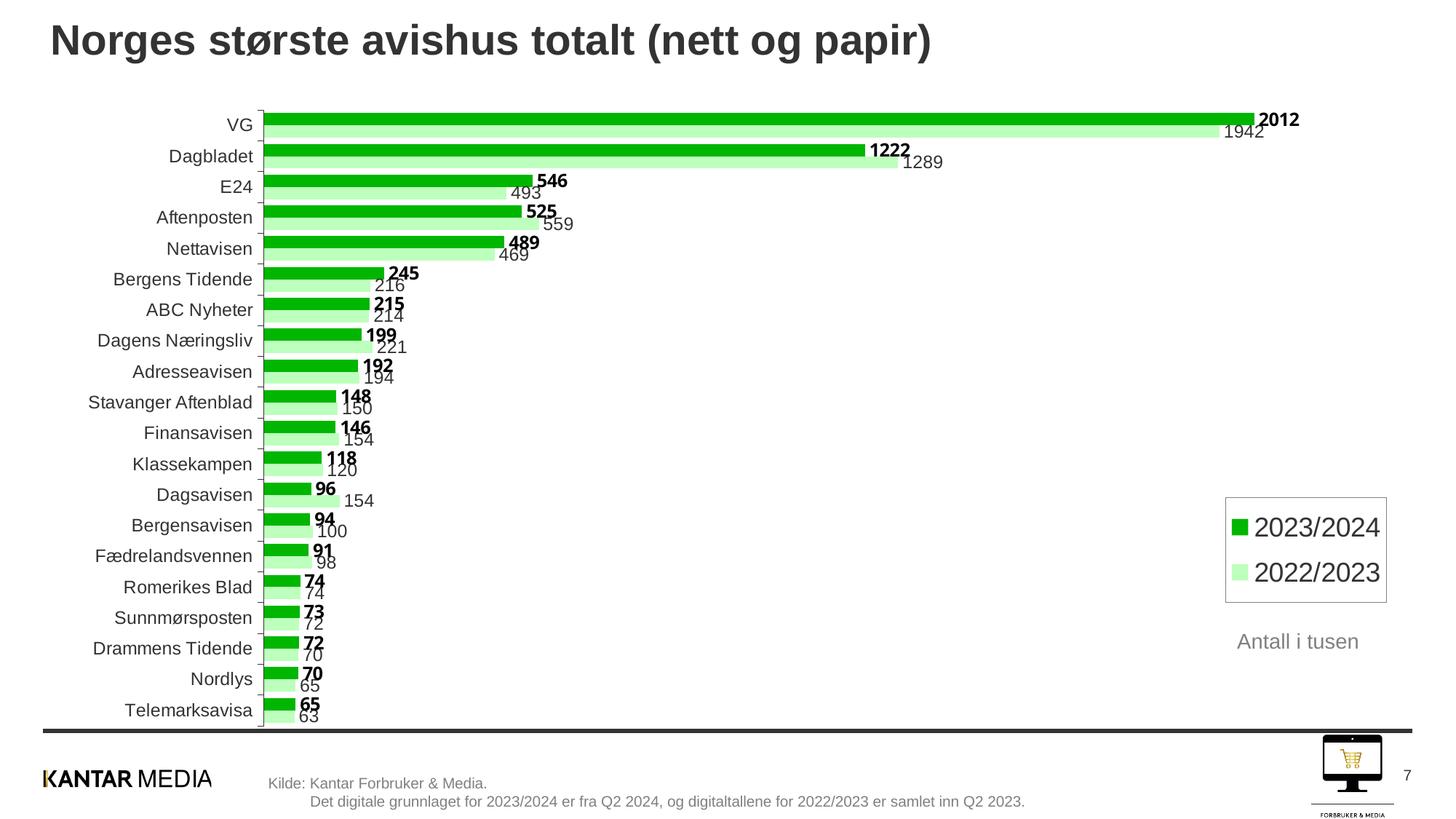
Which is larger for Aftenposten: the 2023/2024 value or the 2022/2023 value? 2022/2023 Which newspaper has the highest 2023/2024 value? VG What is the 2023/2024 value for Nettavisen? 489 How many newspapers are shown in the chart? 20 What kind of chart is shown on the slide? Bar chart What is the difference between the 2023/2024 and 2022/2023 values for VG? 70 What is the 2022/2023 value for Dagsavisen? 154 What is the 2023/2024 value for VG? 2012 Which newspaper has the lowest 2023/2024 value? Telemarksavisa What is the difference between the 2022/2023 and 2023/2024 values for Dagbladet? 67 What is the 2022/2023 value for Dagbladet? 1289 How many series does the legend list? 2